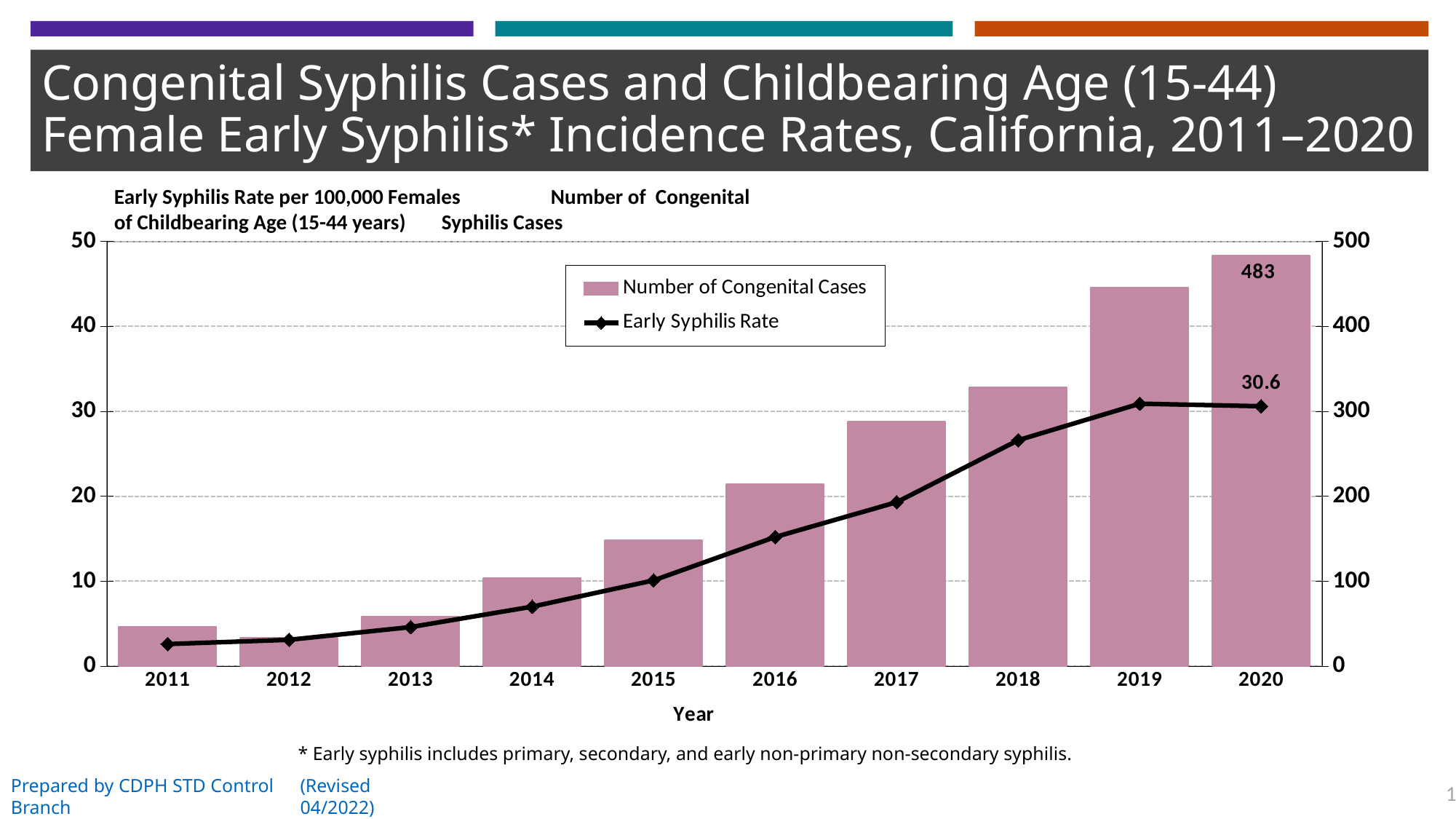
What kind of chart is this? Combined bar and line chart Does the Number of Congenital Cases rise or fall from 2011 to 2020? Rises What are the two entries in the legend? Number of Congenital Cases; Early Syphilis Rate How many years are shown on the x axis? 10 What is the Number of Congenital Cases in 2020? 483 Which year has the highest Number of Congenital Cases? 2020 What is the Early Syphilis Rate in 2020? 30.6 Which year has the lowest Number of Congenital Cases? 2012 How many series does the legend list? 2 Is the Early Syphilis Rate in 2016 greater or less than 20? less Which year has more congenital cases, 2017 or 2018? 2018 Is the Number of Congenital Cases in 2019 greater or less than 400? greater